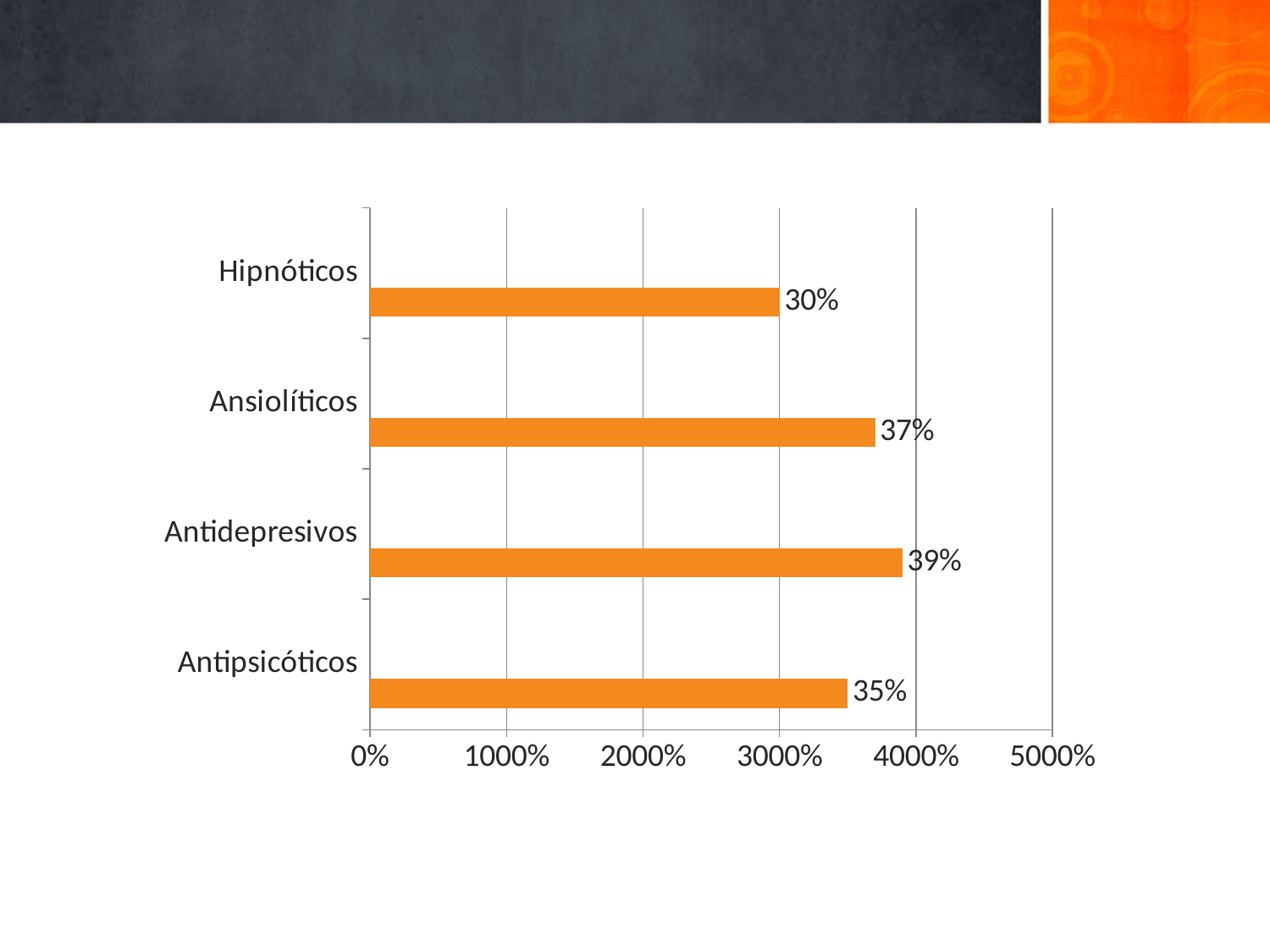
How many categories are shown in the chart? 4 Which is larger, the value for Ansiolíticos or the value for Antipsicóticos? Ansiolíticos Is the bar for Antidepresivos greater or less than the 4000% tick on the axis? less Which category has the lowest value? Hipnóticos What is the difference between the values for Antidepresivos and Hipnóticos? 9% What kind of chart is shown on the slide? Bar chart What is the value shown for Antidepresivos? 39% What is the value shown for Hipnóticos? 30% What is the value shown for Antipsicóticos? 35% What colour are the bars in the chart? Orange What is the value shown for Ansiolíticos? 37% Which category has the highest value? Antidepresivos